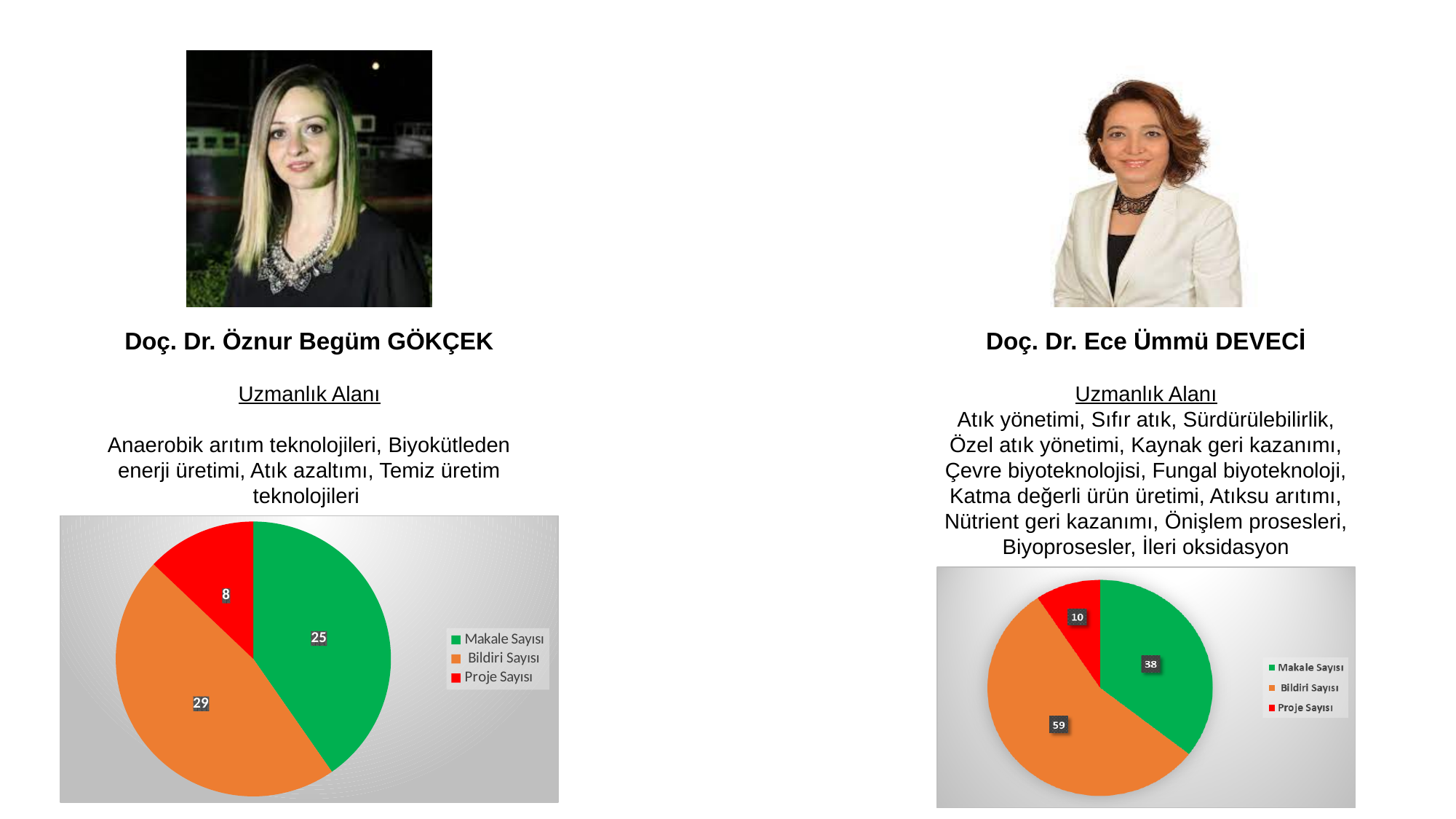
In the left pie chart, what is the difference between Makale Sayısı and Proje Sayısı? 17 What type of chart is shown on the left side of the slide? Pie chart In the left pie chart, which category has the smallest slice? Proje Sayısı In the left pie chart, what is the value for Makale Sayısı? 25 In the left pie chart, which is larger, Makale Sayısı or Bildiri Sayısı? Bildiri Sayısı In the left pie chart, what colour is the Proje Sayısı slice? Red In the left pie chart, what is the value for Bildiri Sayısı? 29 In the right pie chart, which category has the largest slice? Bildiri Sayısı In the right pie chart, what is the value for Proje Sayısı? 10 In the right pie chart, what is the difference between Bildiri Sayısı and Makale Sayısı? 21 How many slices does the right pie chart have? 3 In the right pie chart, what is the value for Bildiri Sayısı? 59